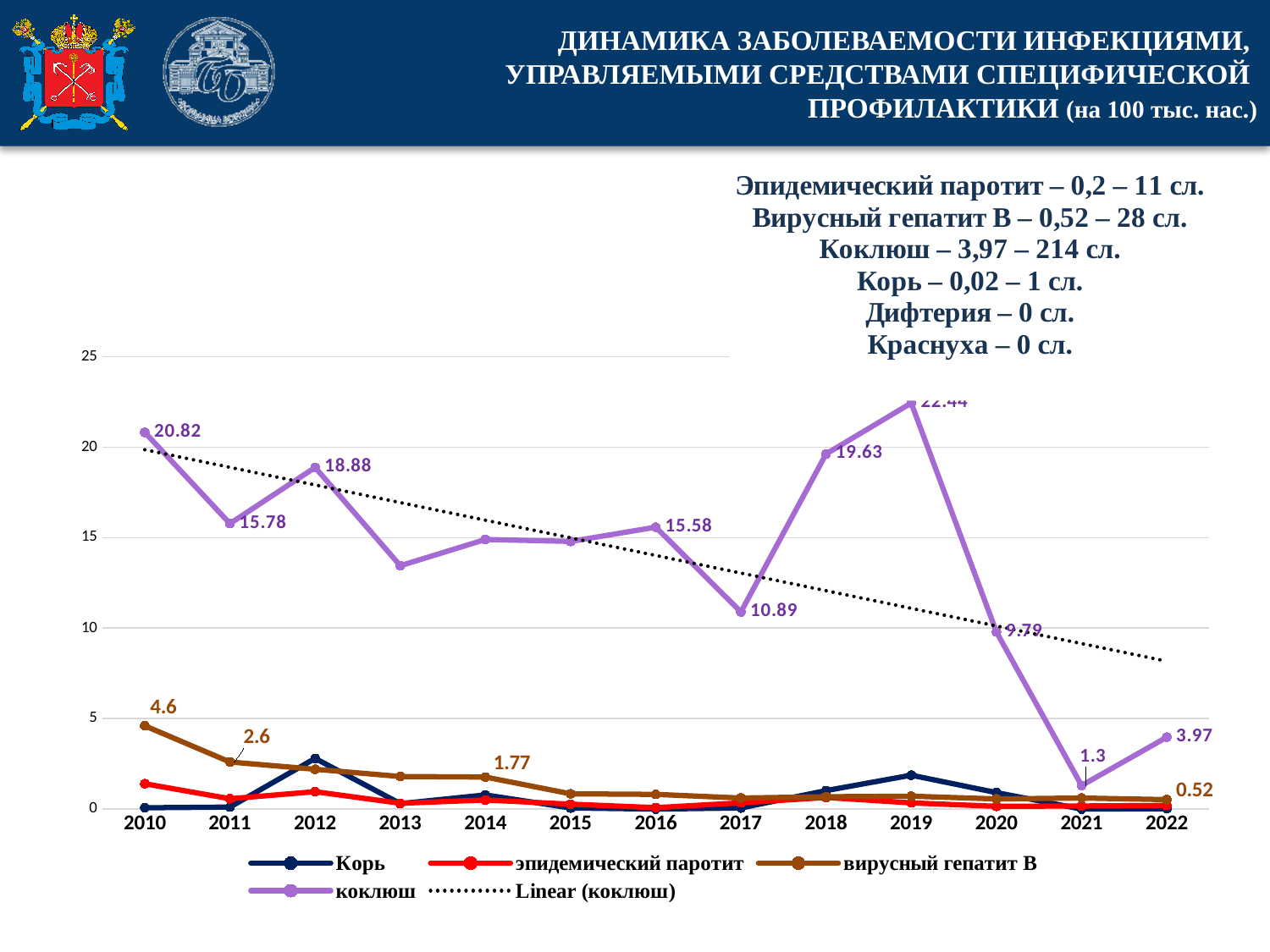
Which year has the higher коклюш value, 2017 or 2018? 2018 How many entries does the chart legend list? 5 What type of chart is shown on the slide? line chart What is the value for коклюш in 2021? 1.3 What is the difference between the вирусный гепатит В values in 2010 and 2011? 2 How many years are shown on the x axis of the chart? 13 What is the difference between the коклюш values in 2010 and 2011? 5.04 What is the value for коклюш in 2010? 20.82 Is the value for коклюш in 2013 greater or less than 15? less What is the value for вирусный гепатит В in 2014? 1.77 What is the value for вирусный гепатит В in 2010? 4.6 In which year does the коклюш series reach its highest value? 2019